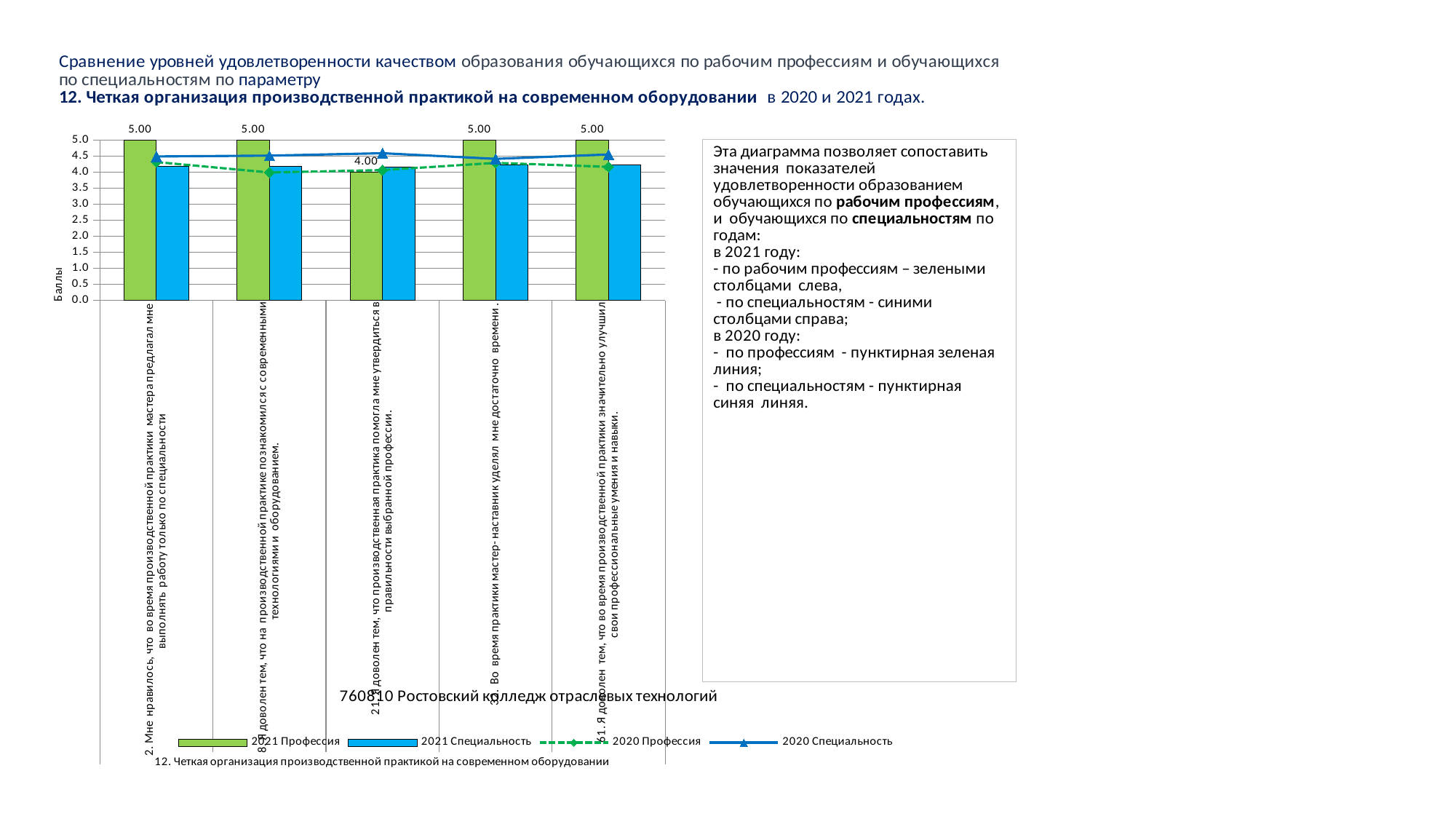
What kind of chart is shown on the slide? A combined bar and line chart For the first category ("2. Мне нравилось..."), which is larger: the 2021 Профессия bar or the 2021 Специальность bar? 2021 Профессия Is the 2021 Специальность value for the first category ("2. Мне нравилось...") greater or less than 4.5? less Is the 2020 Специальность value for the third category ("21. Я доволен тем...") greater or less than 4.0? greater What is the difference between the 2021 Профессия values for the first category ("2. Мне нравилось...") and the third category ("21. Я доволен тем...")? 1.00 Which category has the lowest value for the 2021 Профессия series? 21. Я доволен тем, что производственная практика помогла мне утвердиться в правильности выбранной профессии What colour are the bars for the 2021 Профессия series? Green How many categories are shown on the x axis of the chart? 5 What is the value of the 2021 Профессия bar for the category "21. Я доволен тем, что производственная практика помогла мне утвердиться в правильности выбранной профессии"? 4.00 How many series does the chart legend list? 4 What is the title of the vertical axis of the chart? Баллы